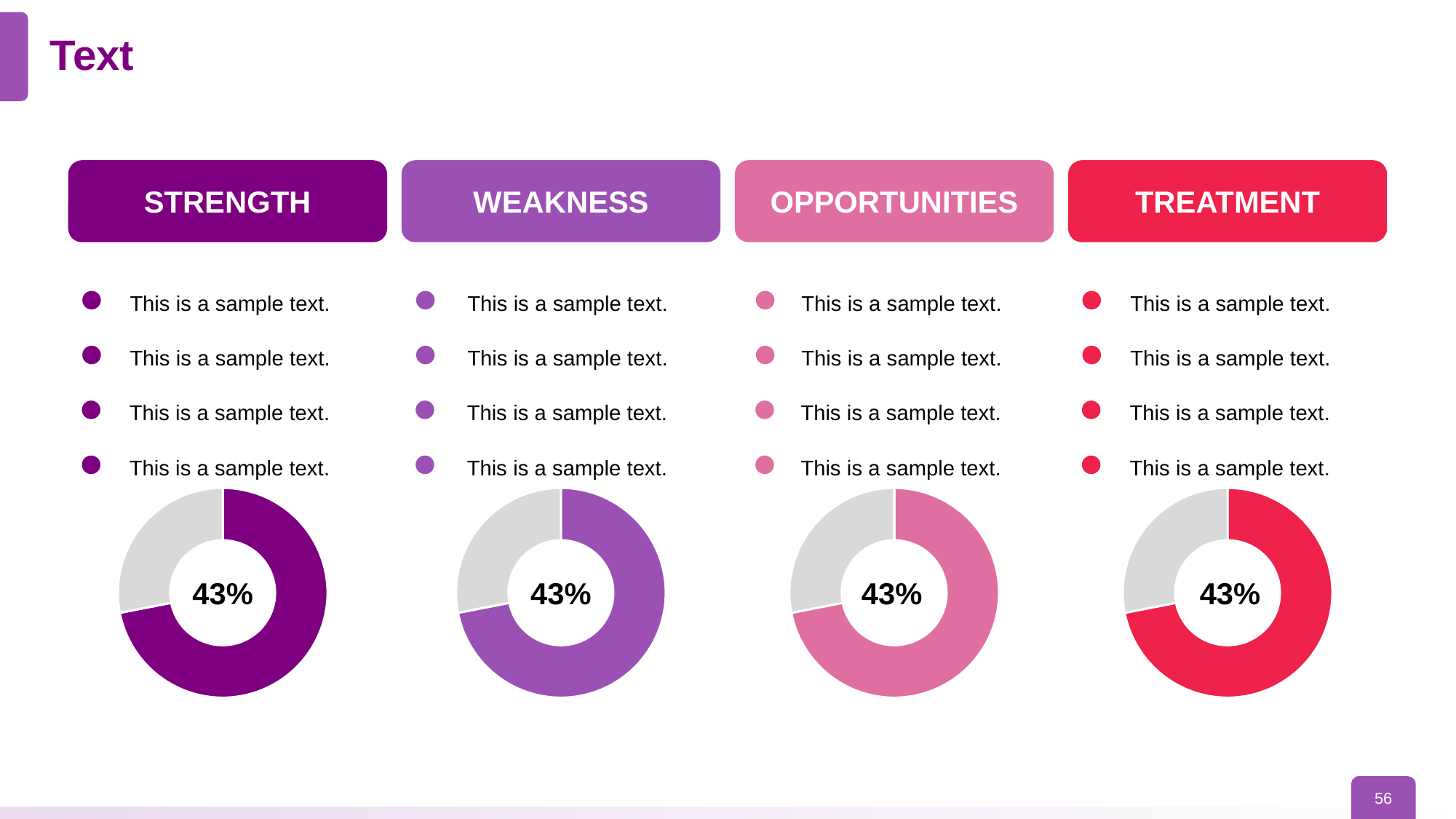
What colour is the non-highlighted segment in each donut chart? Grey What percentage is printed in the centre of the OPPORTUNITIES donut chart? 43% What kind of chart is shown under the STRENGTH heading? Donut chart How many segments does each donut chart have? 2 How many donut charts are on the slide? 4 Which heading sits above the pink donut chart? OPPORTUNITIES What colour is the highlighted segment of the TREATMENT donut chart? Red What percentage is printed in the centre of the STRENGTH donut chart? 43% What percentage is printed in the centre of the TREATMENT donut chart? 43% Is the value printed in the TREATMENT donut chart greater or less than 50%? less What percentage is printed in the centre of the WEAKNESS donut chart? 43%